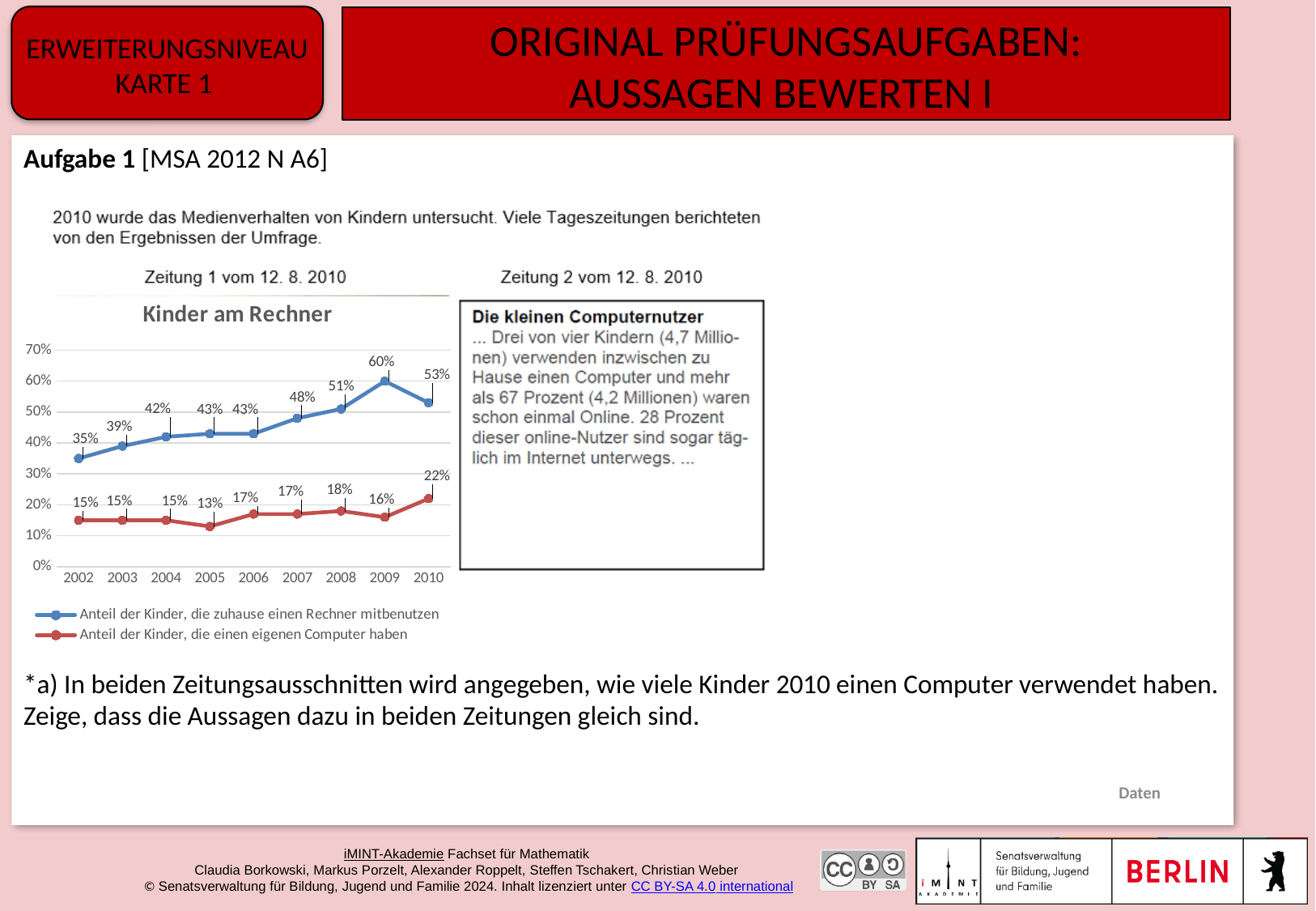
How many years are shown on the x axis of the "Kinder am Rechner" chart? 9 In the "Kinder am Rechner" chart, what is the value for 2010 for the share of children who have their own computer (Anteil der Kinder, die einen eigenen Computer haben)? 22% How many series does the legend of the "Kinder am Rechner" chart list? 2 In the "Kinder am Rechner" chart, which colour is used for the series "Anteil der Kinder, die einen eigenen Computer haben"? red In the "Kinder am Rechner" chart, in which year is the share of children who share a computer at home highest? 2009 What type of chart is "Kinder am Rechner"? line chart In the "Kinder am Rechner" chart, what is the value for 2009 for the share of children who share a computer at home (Anteil der Kinder, die zuhause einen Rechner mitbenutzen)? 60% In the "Kinder am Rechner" chart, in which year is the share of children who have their own computer lowest? 2005 In the "Kinder am Rechner" chart, what is the difference between the 2009 and 2010 values for children who share a computer at home? 7% In the "Kinder am Rechner" chart, which is larger: the share of children sharing a computer at home in 2002 or in 2010? 2010 In the "Kinder am Rechner" chart, does the share of children who share a computer at home generally rise or fall from 2002 to 2009? rise In the "Kinder am Rechner" chart, what is the difference between the 2010 values of the two series (53% and 22%)? 31%